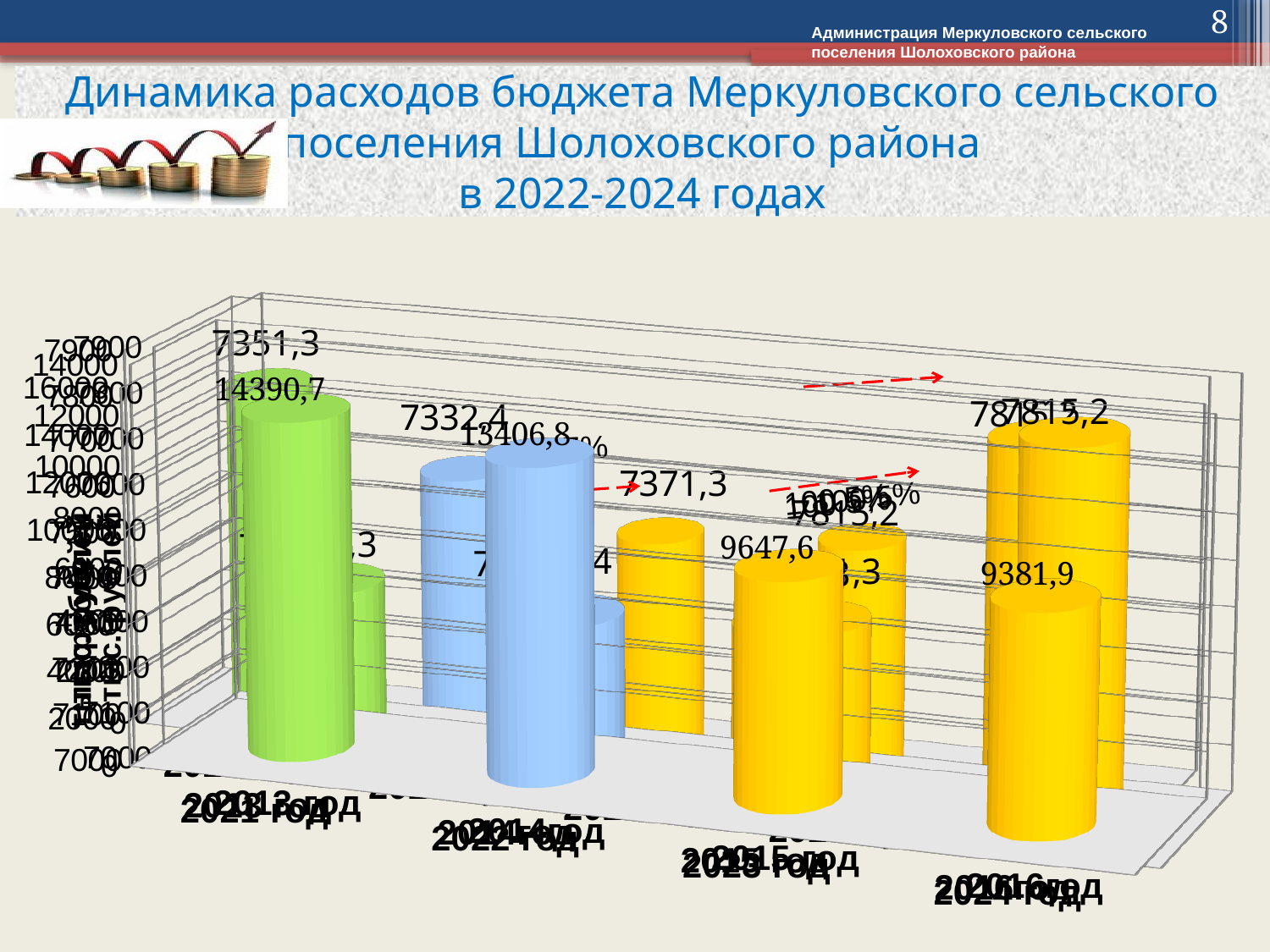
In the front chart, what is the value of the large yellow bar labelled for 2024 год? 9381,9 In the front chart, what is the value of the large yellow bar labelled for 2023 год? 9647,6 In the front chart, what is the difference between the 2023 год value (9647,6) and the 2024 год value (9381,9)? 265,7 In the front chart, what is the difference between the 2021 год value (14390,7) and the 2022 год value (13406,8)? 983,9 In the front chart, what is the value of the tallest blue bar labelled for 2022 год? 13406,8 In the front chart, do the values of the large bars rise or fall from 2021 год to 2024 год? fall In the front chart, which year has the highest value among the large bars? 2021 год In the front chart, what is the value of the tallest green bar labelled for 2021 год? 14390,7 What kind of chart is shown on the slide? bar chart What is the title of the slide's chart? Динамика расходов бюджета Меркуловского сельского поселения Шолоховского района в 2022-2024 годах In the front chart, which is larger: the value for 2021 год (14390,7) or the value for 2022 год (13406,8)? 2021 год In the front chart, which year has the lowest value among the large bars? 2024 год